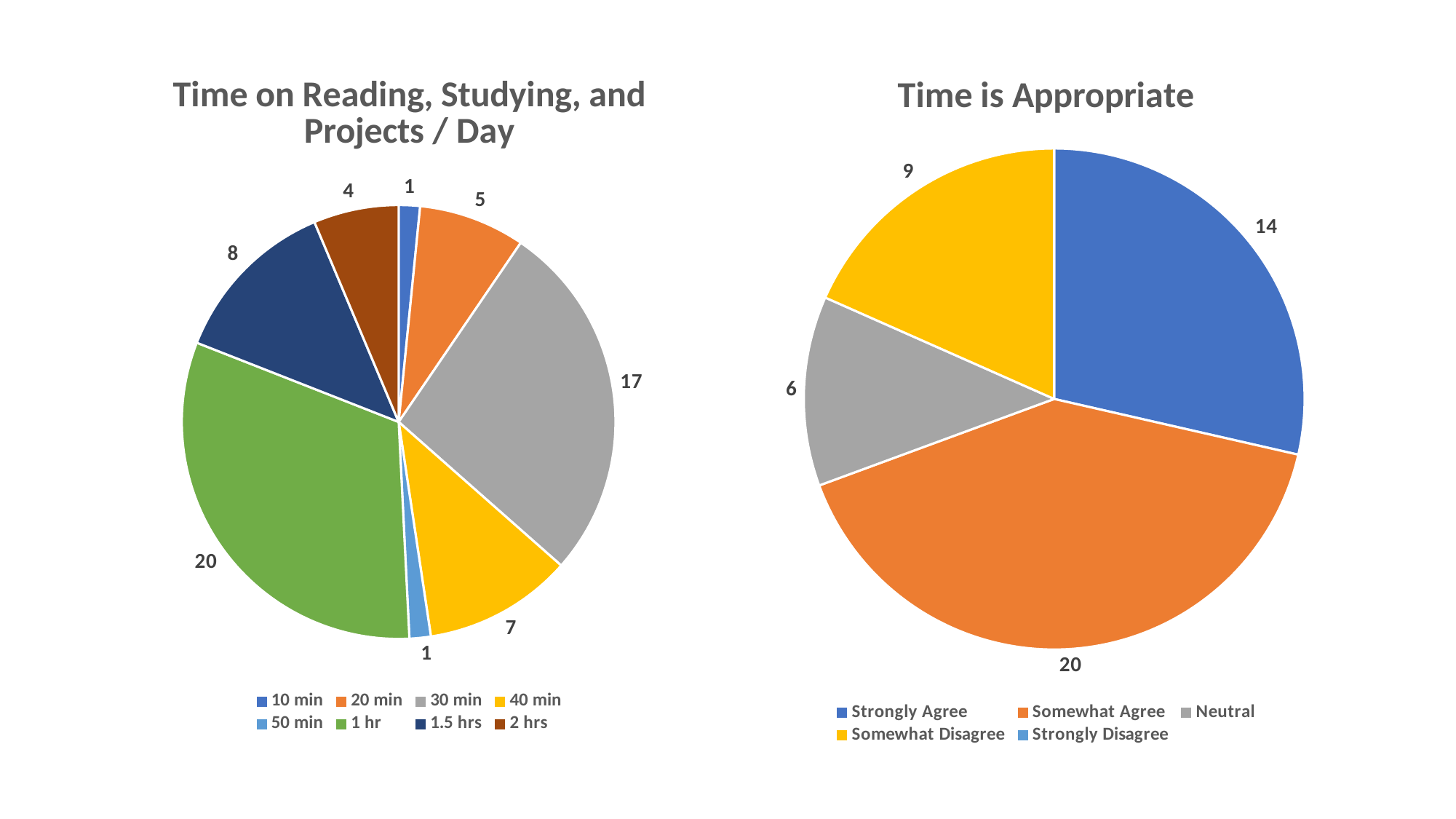
In the 'Time on Reading, Studying, and Projects / Day' chart, which is larger, 40 min or 2 hrs? 40 min In the 'Time on Reading, Studying, and Projects / Day' chart, what is the difference between the 1 hr value and the 30 min value? 3 In the 'Time is Appropriate' chart, what is the value for Neutral? 6 In the 'Time is Appropriate' chart, which labelled category has the smallest slice? Neutral In the 'Time on Reading, Studying, and Projects / Day' chart, which category has the largest slice? 1 hr In the 'Time on Reading, Studying, and Projects / Day' chart, what is the value for 30 min? 17 What kind of chart is 'Time is Appropriate'? Pie chart In the 'Time on Reading, Studying, and Projects / Day' chart, what is the value for 1.5 hrs? 8 How many entries does the legend of the 'Time is Appropriate' chart list? 5 In the 'Time is Appropriate' chart, what is the difference between Strongly Agree and Somewhat Disagree? 5 In the 'Time is Appropriate' chart, what is the value for Somewhat Agree? 20 How many categories does the legend of the 'Time on Reading, Studying, and Projects / Day' chart list? 8